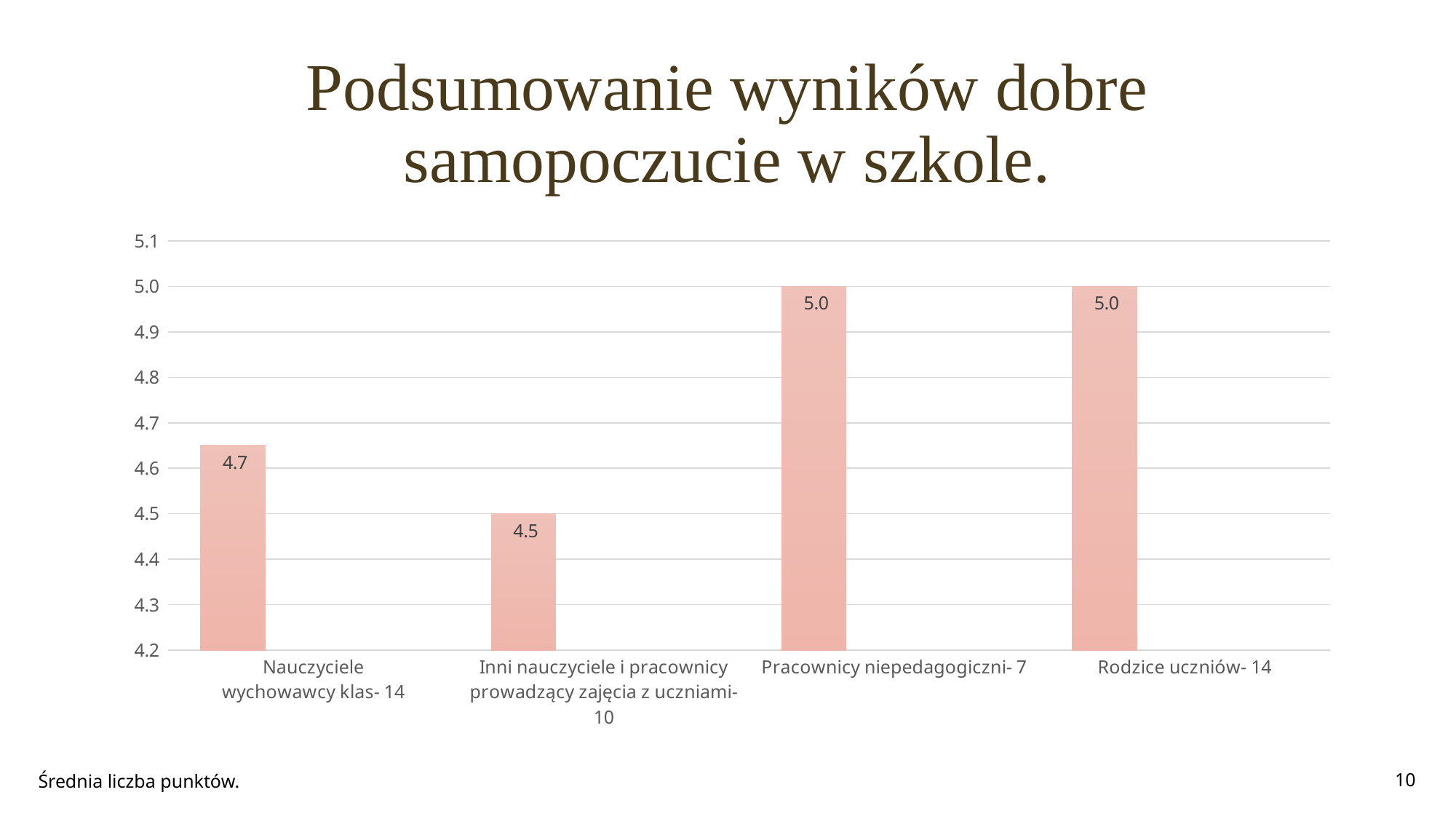
How many categories are shown on the chart? 4 What is the value for Nauczyciele wychowawcy klas- 14? 4.7 What kind of chart is shown on the slide? bar chart What is the title of the slide? Podsumowanie wyników dobre samopoczucie w szkole. What is the difference between the value for Rodzice uczniów- 14 and the value for Inni nauczyciele i pracownicy prowadzący zajęcia z uczniami- 10? 0.5 What is the value for Pracownicy niepedagogiczni- 7? 5.0 What is the value for Rodzice uczniów- 14? 5.0 Which is larger: the value for Rodzice uczniów- 14 or the value for Nauczyciele wychowawcy klas- 14? Rodzice uczniów- 14 Which category has the lowest value? Inni nauczyciele i pracownicy prowadzący zajęcia z uczniami- 10 What is the difference between the value for Pracownicy niepedagogiczni- 7 and the value for Nauczyciele wychowawcy klas- 14? 0.3 Is the value for Inni nauczyciele i pracownicy prowadzący zajęcia z uczniami- 10 greater or less than 4.6? less What is the value for Inni nauczyciele i pracownicy prowadzący zajęcia z uczniami- 10? 4.5